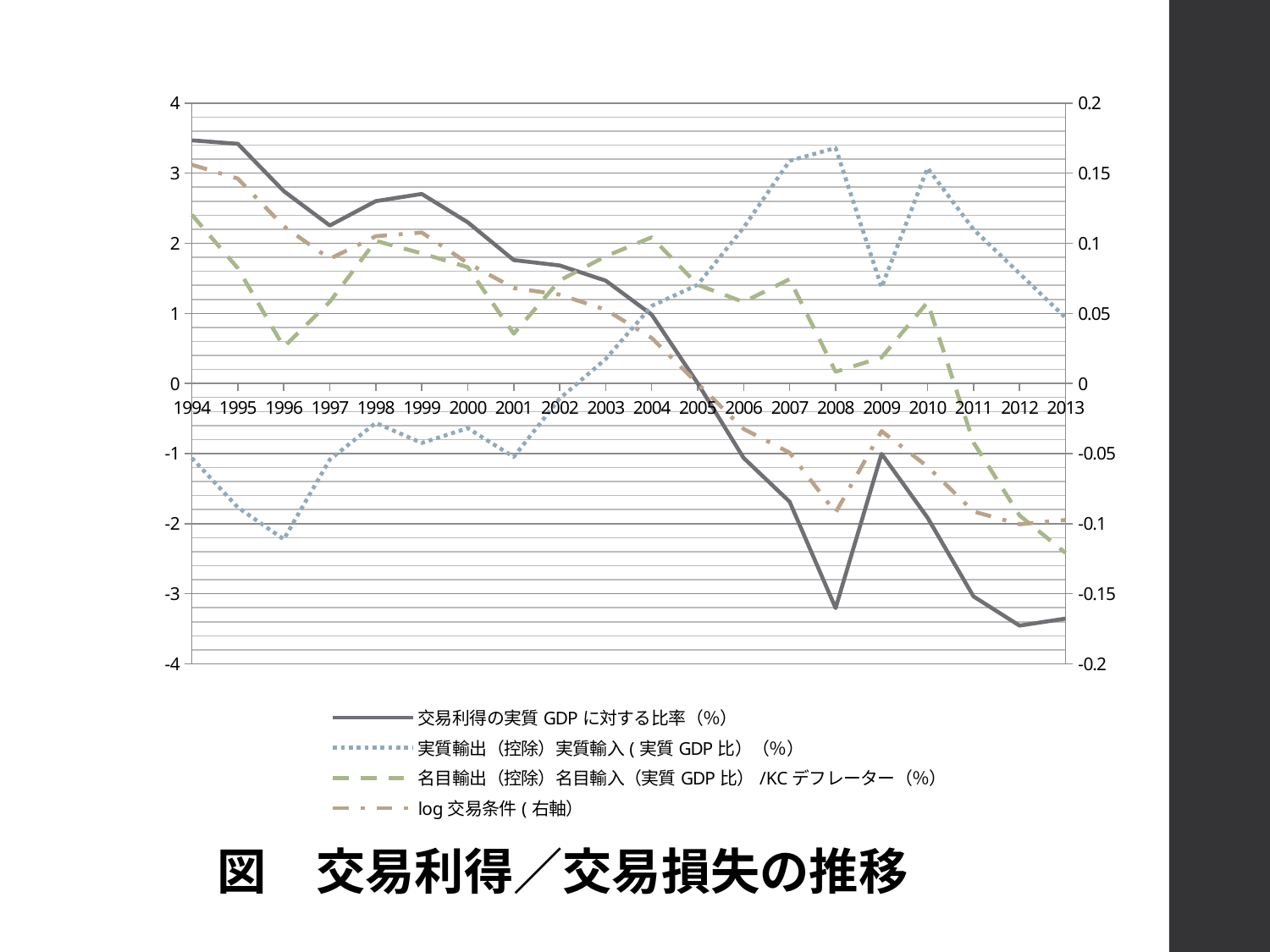
In which year is the 実質輸出（控除）実質輸入（実質GDP比）（%） series highest? 2008 Which is larger for the 実質輸出（控除）実質輸入（実質GDP比）（%） series: the value in 2008 or the value in 2009? 2008 Is the value of the 交易利得の実質GDPに対する比率（%） series in 1994 greater or less than 3? greater What is the title shown below the chart? 図 交易利得／交易損失の推移 How many years are plotted along the x axis? 20 Does the log交易条件（右軸） series rise or fall from 1994 to 2013? fall In which year is the 名目輸出（控除）名目輸入（実質GDP比）/KCデフレーター（%） series lowest? 2013 Does the 交易利得の実質GDPに対する比率（%） series rise or fall from 1994 to 2013? fall In which year is the 実質輸出（控除）実質輸入（実質GDP比）（%） series lowest? 1996 Is the value of the 交易利得の実質GDPに対する比率（%） series in 2008 greater or less than -3? less How many series does the legend list? 4 What kind of chart is shown on the slide? line chart